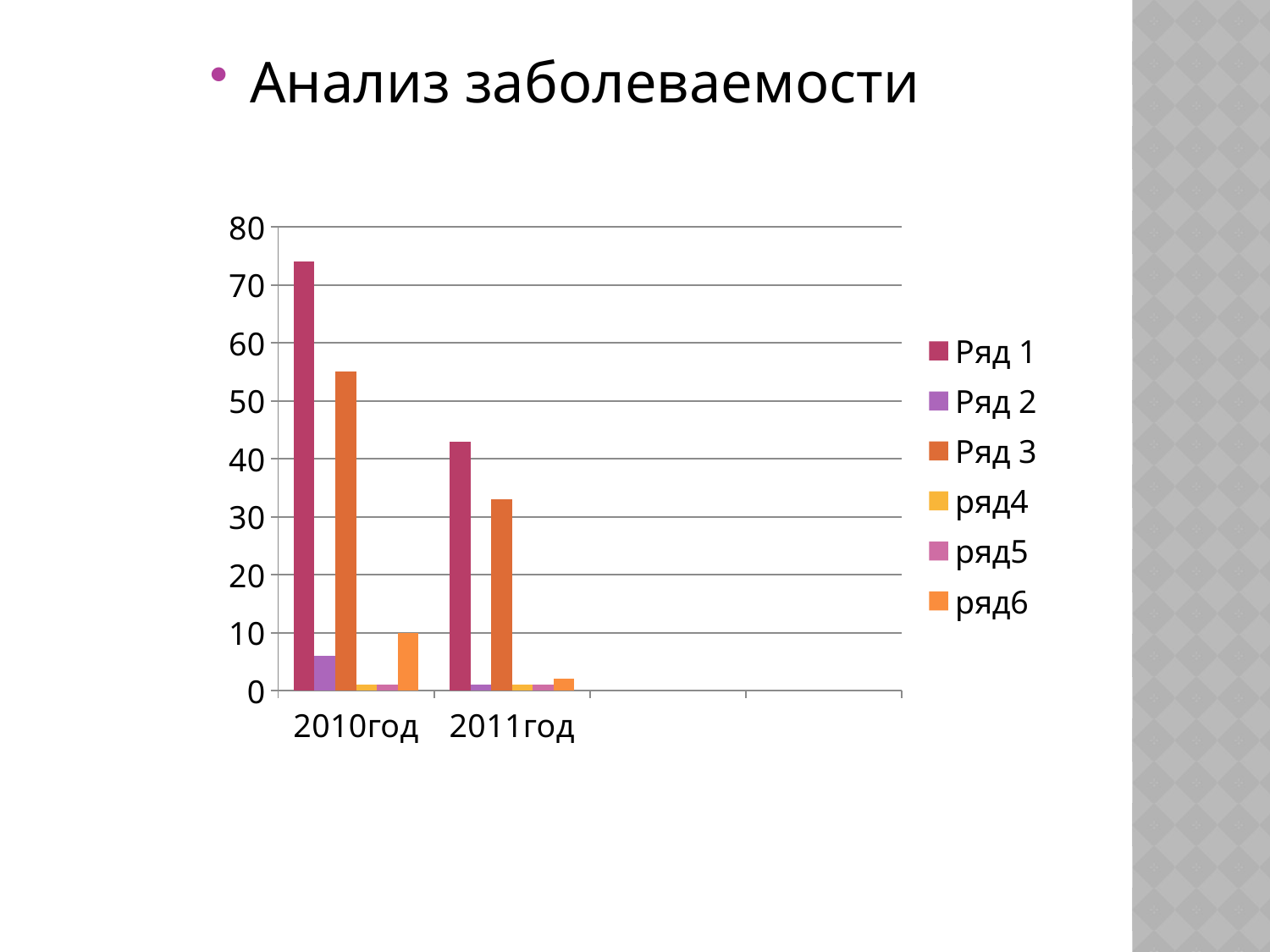
What kind of chart is shown on the slide? bar chart What is the title of the slide above the chart? Анализ заболеваемости Is the value for Ряд 1 in 2011год greater or less than 40? greater Which is larger for Ряд 1: the value for 2010год or 2011год? 2010год Which series has the highest value in 2010год? Ряд 1 What is the value for ряд6 in 2010год? 10 Is the value for Ряд 3 in 2010год greater or less than 50? greater Is the value for Ряд 3 in 2011год greater or less than 40? less How many series does the legend list? 6 Does the value for Ряд 3 rise or fall from 2010год to 2011год? fall How many categories are shown on the x axis? 2